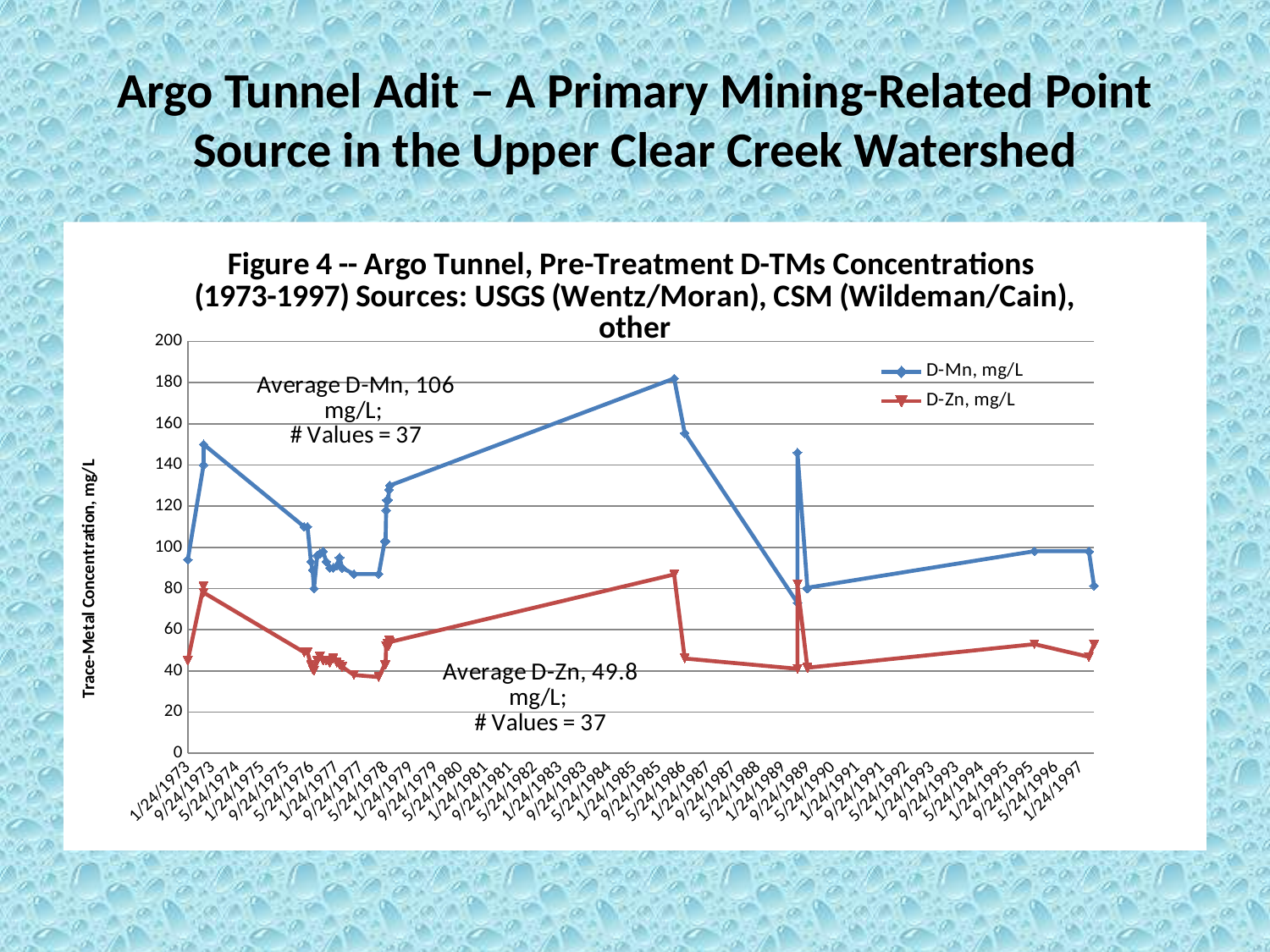
What average D-Mn concentration is stated on the chart? 106 mg/L What are the two series named in the legend? D-Mn, mg/L and D-Zn, mg/L How many series does the legend list? 2 Which series has the higher stated average concentration, D-Mn or D-Zn? D-Mn What is the label of the vertical axis? Trace-Metal Concentration, mg/L Is the D-Zn value at 1/24/1973 greater or less than 60? less Which series is plotted higher across the whole time range, D-Mn or D-Zn? D-Mn Is the highest D-Mn value on the chart greater or less than 160? greater Is the highest D-Zn value on the chart greater or less than 100? less What average D-Zn concentration is stated on the chart? 49.8 mg/L How many values does the chart state were used for the D-Mn average? 37 What type of chart is shown on the slide? line chart